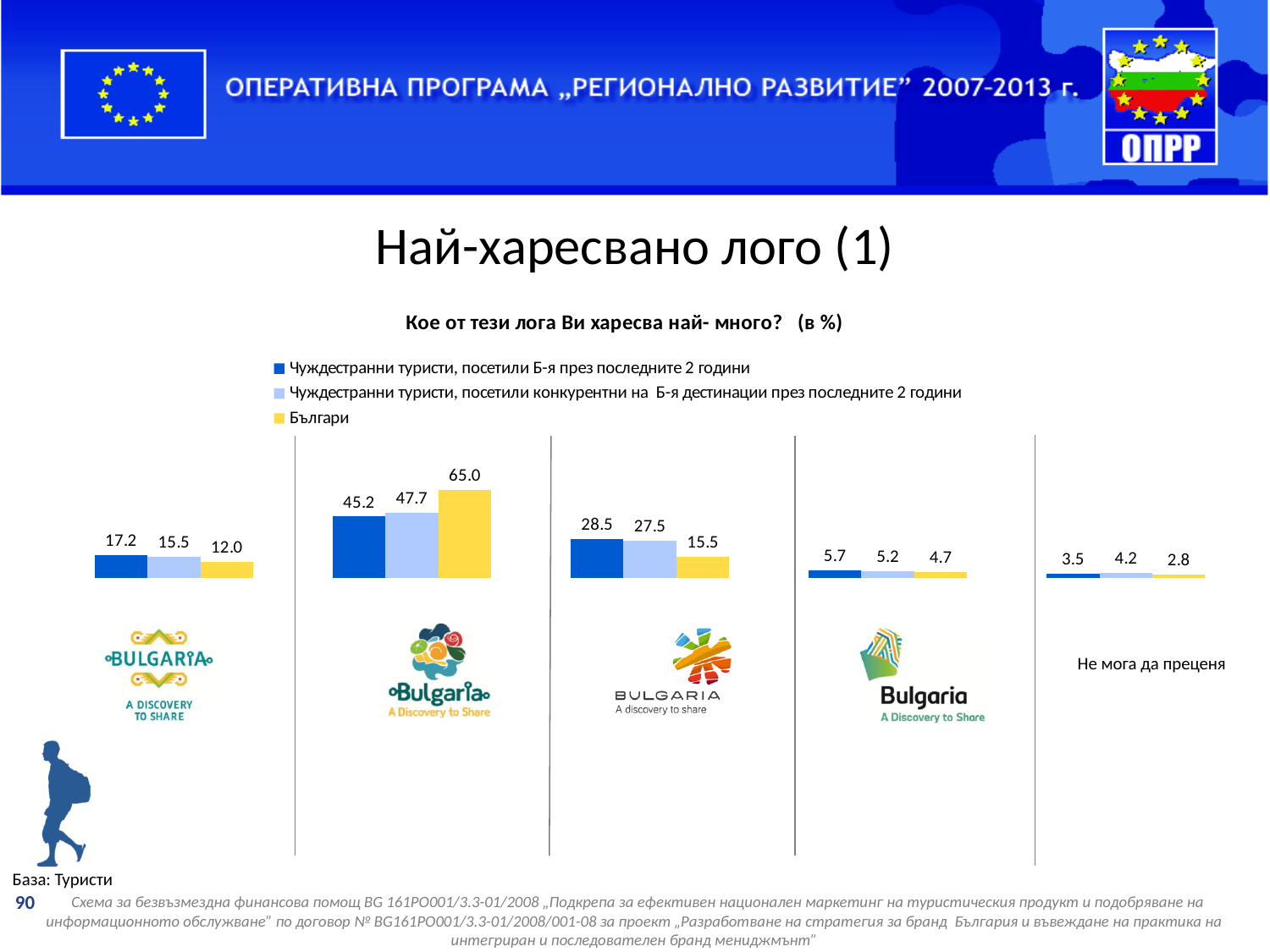
Which category has the lowest value for the "Българи" series? Не мога да преценя What kind of chart is shown on the slide? bar chart What is the value for "Чуждестранни туристи, посетили Б-я през последните 2 години" for the third logo from the left? 28.5 How many categories (logo options) are shown along the x axis of the chart? 5 What is the value for "Българи" for the second logo from the left? 65.0 What is the title of the chart? Кое от тези лога Ви харесва най- много? (в %) What is the difference between the "Българи" value and the "Чуждестранни туристи, посетили Б-я през последните 2 години" value for the second logo from the left? 19.8 How many series does the chart legend list? 3 For the first logo from the left, which is larger: the value for "Чуждестранни туристи, посетили Б-я през последните 2 години" or the value for "Българи"? Чуждестранни туристи, посетили Б-я през последните 2 години What is the value for "Чуждестранни туристи, посетили конкурентни на Б-я дестинации през последните 2 години" for the category "Не мога да преценя"? 4.2 Which category has the highest value for the "Българи" series? the second logo from the left What is the difference between the two foreign-tourist series values (45.2 and 47.7) for the second logo from the left? 2.5